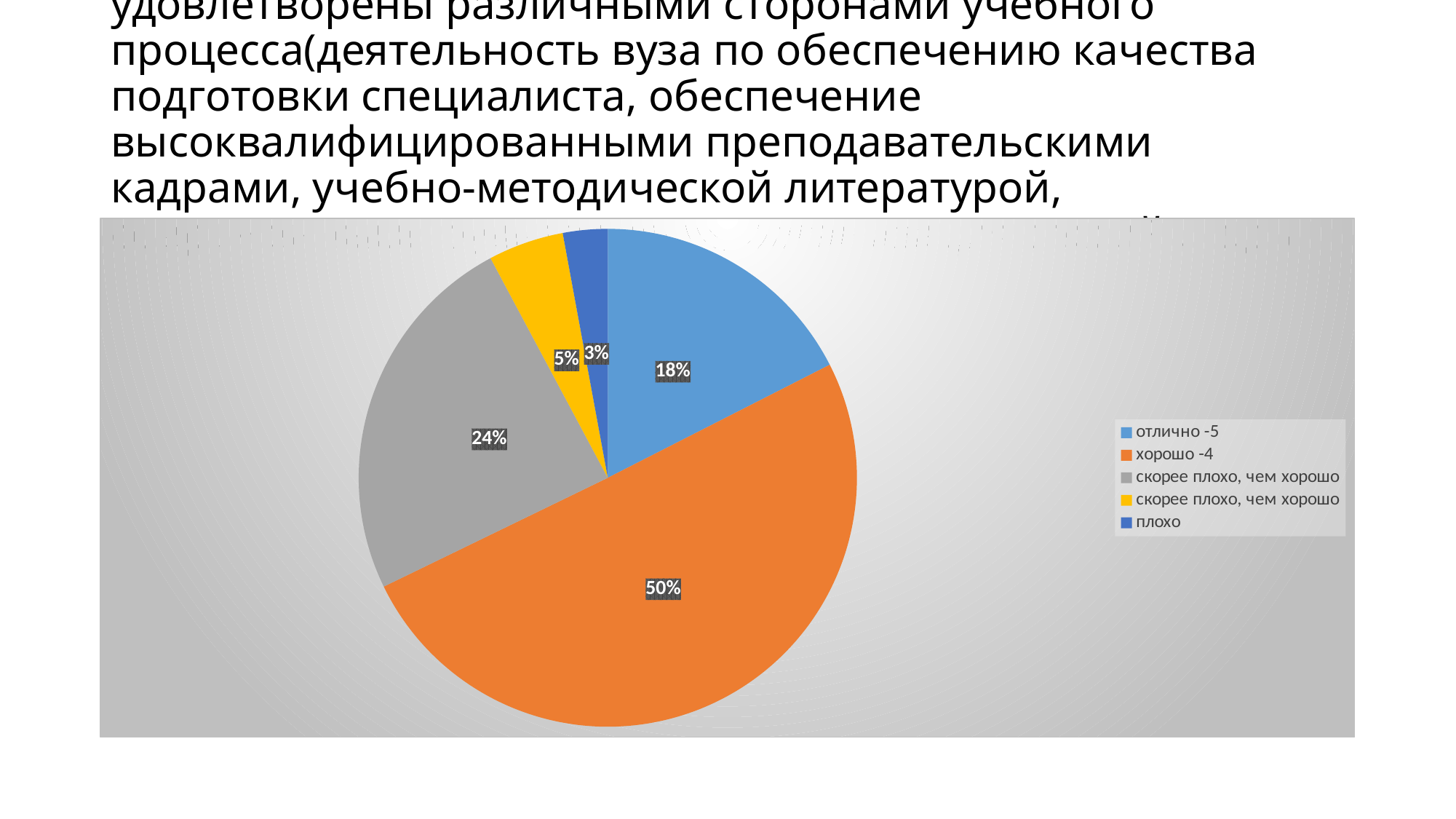
What share of the pie does the "хорошо -4" slice have? 50% What is the difference between the "хорошо -4" share and the "отлично -5" share? 32% How many slices does the pie chart have? 5 What kind of chart is shown on the slide? pie chart Which category has the largest slice of the pie? хорошо -4 Which category has the smallest slice of the pie? плохо Which is larger, the "отлично -5" slice or the "плохо" slice? отлично -5 What share of the pie does the "отлично -5" slice have? 18% What percentage is shown on the yellow slice of the pie? 5% What percentage is shown on the gray slice of the pie? 24% What share of the pie does the "плохо" slice have? 3% How many entries does the legend list? 5